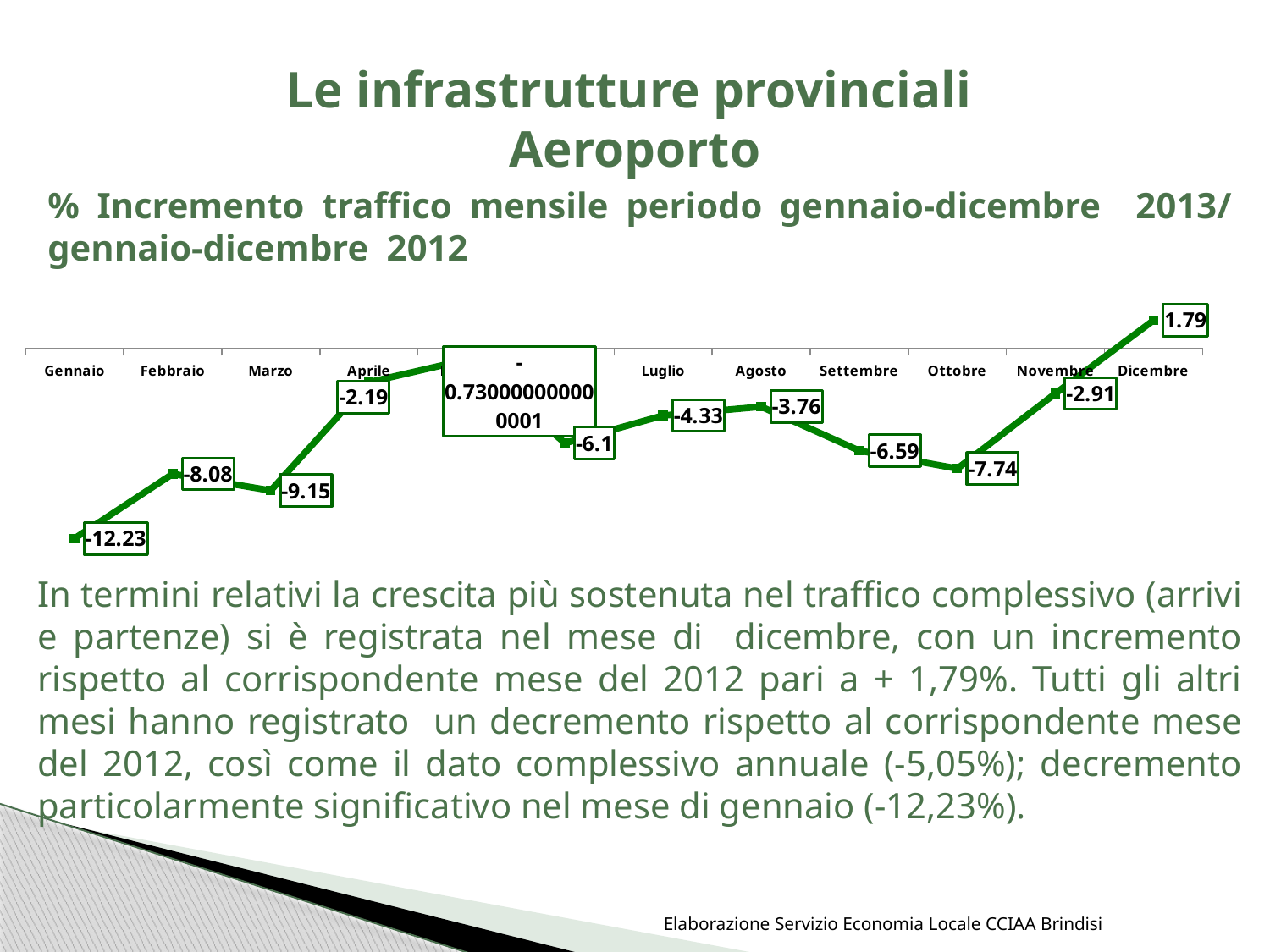
Which is higher, the value for Febbraio or the value for Marzo? Febbraio What is the difference between the values for Febbraio and Marzo? 1.07 Which month has the lowest value? Gennaio What kind of chart is shown on the slide? Line chart What is the difference between the values for Dicembre and Gennaio? 14.02 Which month has the highest value? Dicembre What is the value for Agosto? -3.76 Which is higher, the value for Aprile or the value for Novembre? Aprile Does the value rise or fall from Ottobre to Dicembre? Rise What is the value for Gennaio? -12.23 What is the value for Settembre? -6.59 What is the value for Dicembre? 1.79